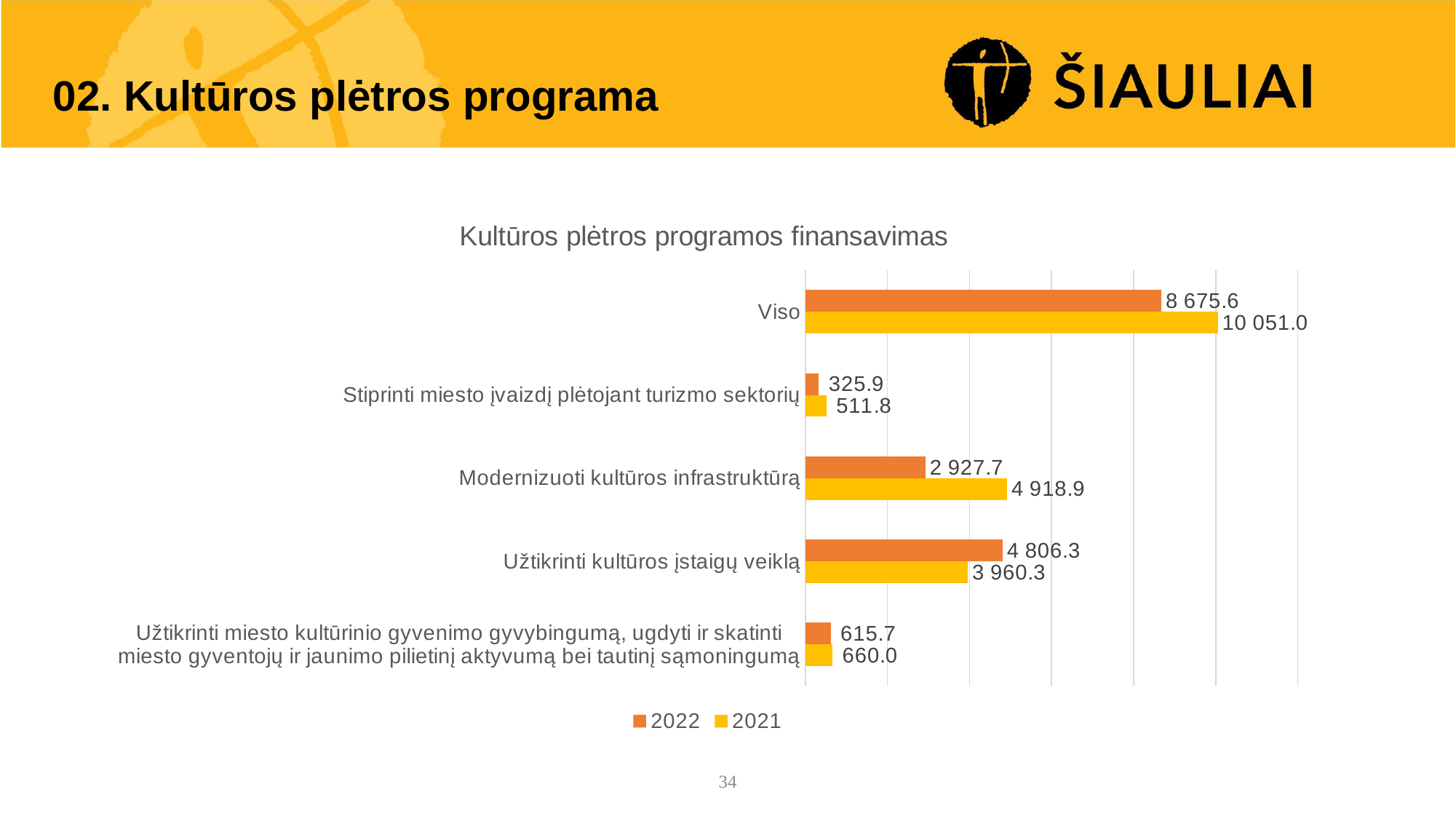
What is the 2022 value for Užtikrinti kultūros įstaigų veiklą? 4 806.3 What is the title of the chart? Kultūros plėtros programos finansavimas What is the 2022 value for Viso? 8 675.6 What is the 2021 value for Modernizuoti kultūros infrastruktūrą? 4 918.9 For Užtikrinti kultūros įstaigų veiklą, which year has the larger value, 2022 or 2021? 2022 Excluding Viso, which category has the lowest 2022 value? Stiprinti miesto įvaizdį plėtojant turizmo sektorių How many series does the legend list? 2 What kind of chart is shown on the slide? Bar chart What is the difference between the 2021 and 2022 values for Viso? 1 375.4 Excluding Viso, which category has the highest 2021 value? Modernizuoti kultūros infrastruktūrą What is the 2021 value for Stiprinti miesto įvaizdį plėtojant turizmo sektorių? 511.8 How many categories are shown on the chart? 5